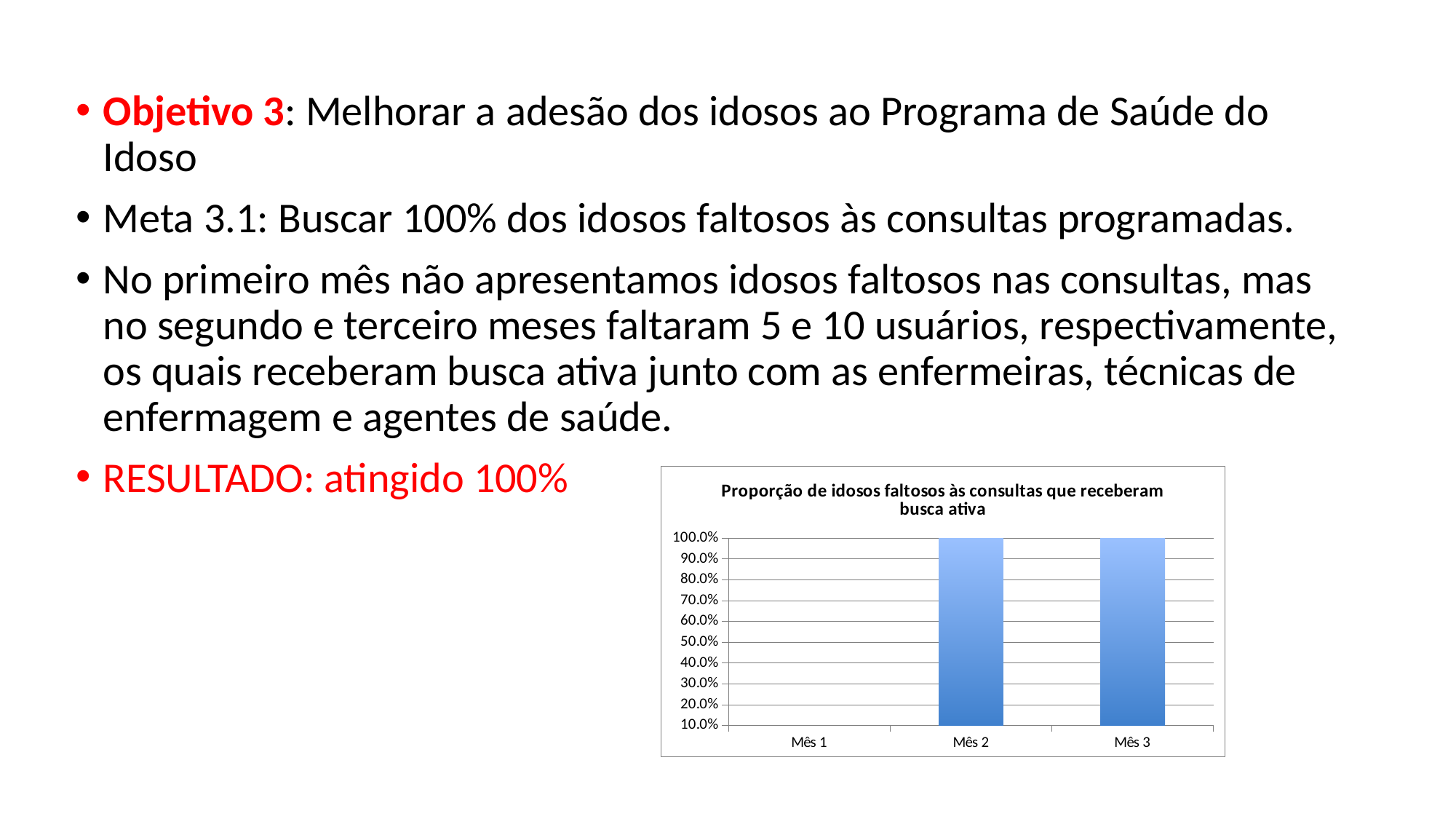
What type of chart is shown on the slide? bar chart How many categories are shown on the x axis of the chart? 3 Which is larger, the value for Mês 1 or the value for Mês 2? Mês 2 What is the value for Mês 3? 100.0% Which category has the lowest value in the chart? Mês 1 Is the value for Mês 2 greater or less than 50.0%? greater Which is larger, the value for Mês 3 or the value for Mês 1? Mês 3 How many categories in the chart have a visible bar? 2 What is the title of the chart? Proporção de idosos faltosos às consultas que receberam busca ativa What colour are the bars in the chart? blue What is the value for Mês 2? 100.0% Is the value for Mês 3 greater or less than 90.0%? greater